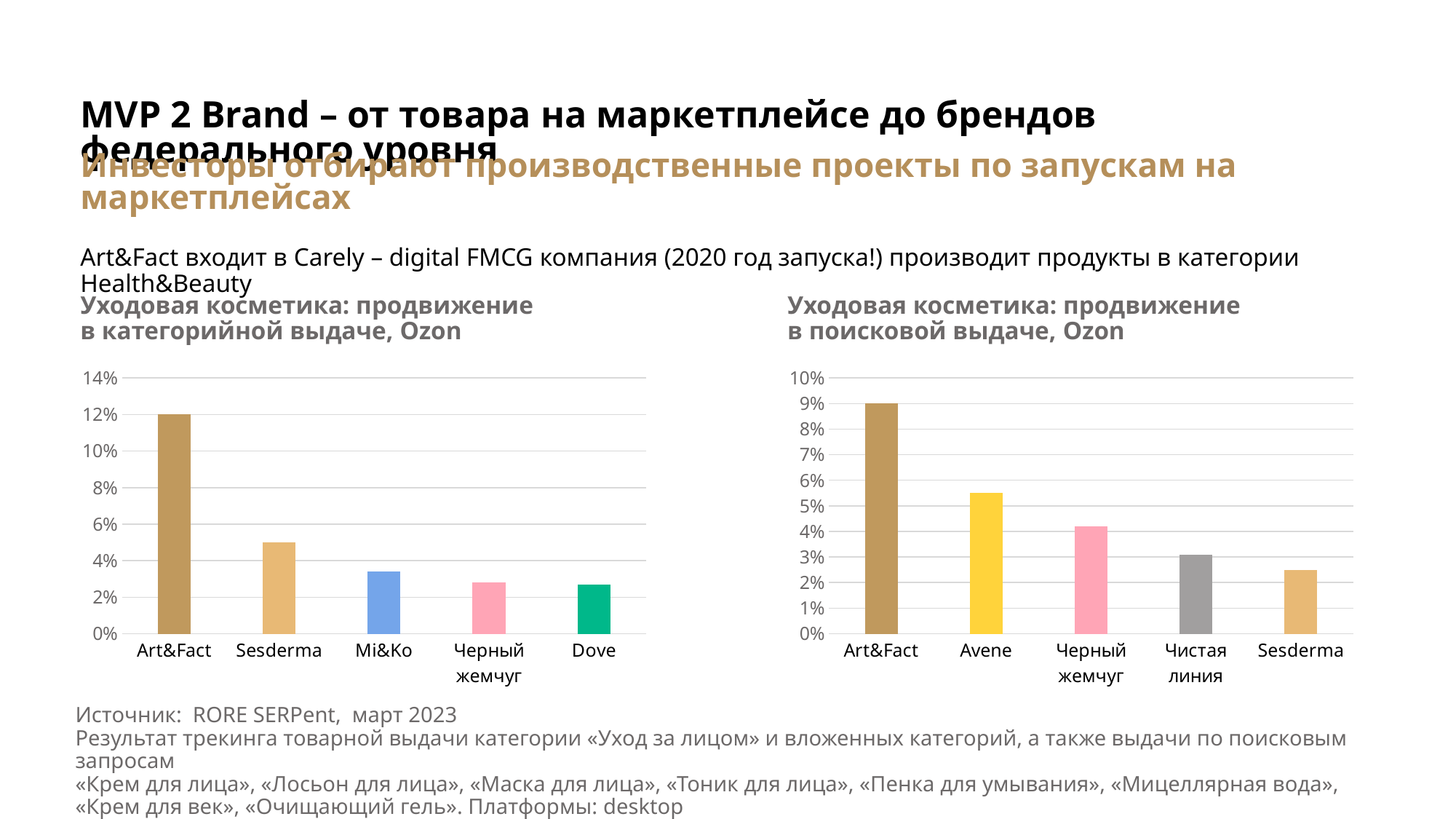
In the left chart (категорийная выдача), which brand has the highest value? Art&Fact In the left chart (категорийная выдача), is the value for Mi&Ko greater or less than 4%? less In the right chart (поисковая выдача), which brand has the lowest value? Sesderma How many brands are shown in the left chart (категорийная выдача)? 5 In the right chart (поисковая выдача), is the value for Avene greater or less than 5%? greater In the left chart (категорийная выдача), which is larger, the value for Sesderma or the value for Mi&Ko? Sesderma In the right chart (поисковая выдача), which is larger, the value for Черный жемчуг or the value for Чистая линия? Черный жемчуг In the left chart (категорийная выдача), what is the value for Art&Fact? 12% In the right chart (поисковая выдача), what is the value for Art&Fact? 9% In the right chart (поисковая выдача), which brand has the highest value? Art&Fact In the left chart (категорийная выдача), is the value for Sesderma greater or less than 4%? greater What type of chart is the right chart (поисковая выдача)? Bar chart